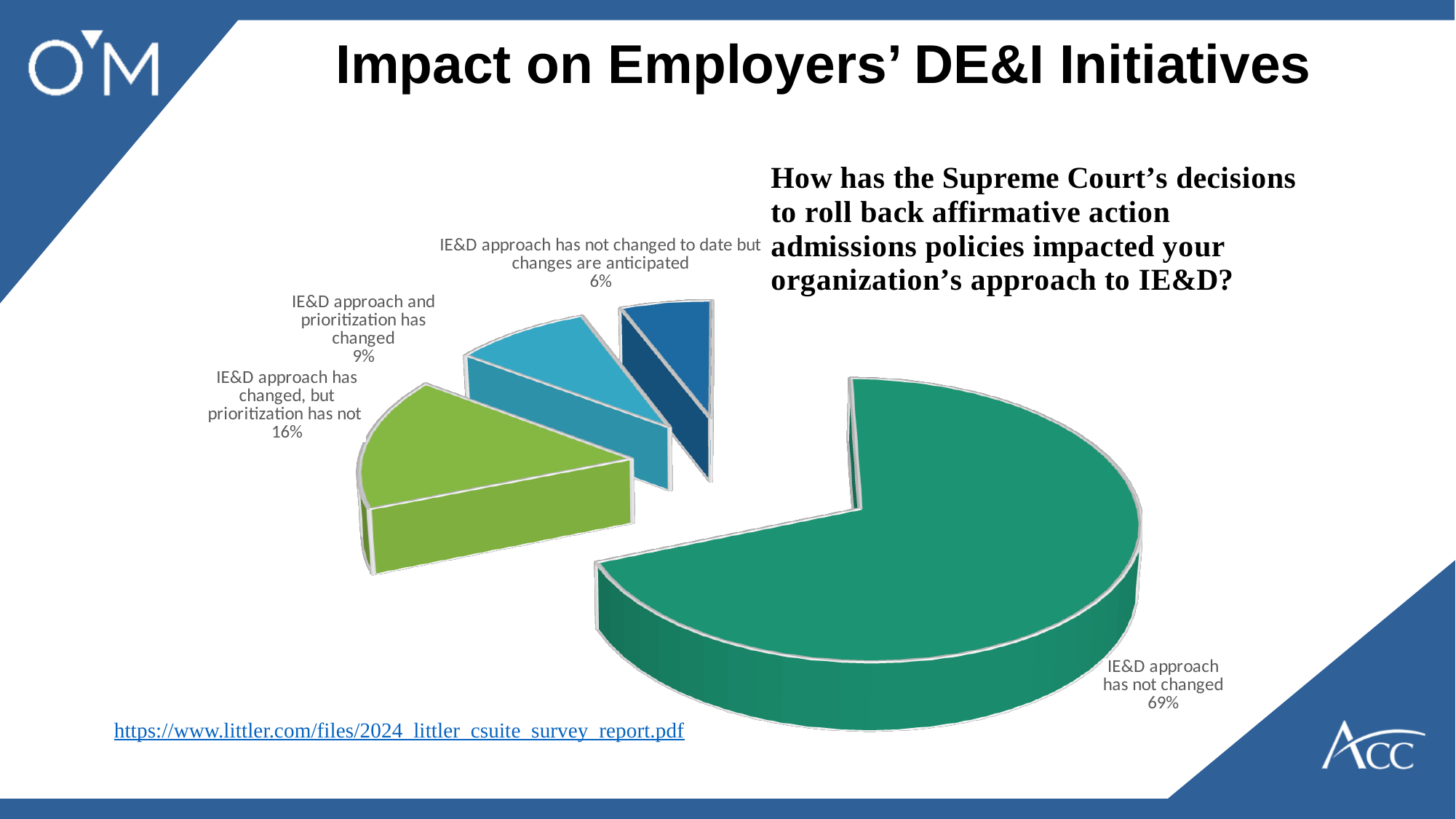
Which category has the smallest slice of the pie? IE&D approach has not changed to date but changes are anticipated What share of respondents said their IE&D approach has changed, but prioritization has not? 16% Which category has the largest slice of the pie? IE&D approach has not changed What kind of chart is shown on the slide? Pie chart What share of respondents said their IE&D approach has not changed to date but changes are anticipated? 6% What is the combined share of the three categories other than 'IE&D approach has not changed'? 31% What is the difference in percentage points between 'IE&D approach has not changed' and 'IE&D approach has changed, but prioritization has not'? 53 How many slices does the pie chart have? 4 What survey question does the pie chart answer, according to the text on the slide? How has the Supreme Court's decisions to roll back affirmative action admissions policies impacted your organization's approach to IE&D? What share of respondents said their IE&D approach and prioritization has changed? 9% Which is larger: the share for 'IE&D approach and prioritization has changed' or the share for 'IE&D approach has not changed to date but changes are anticipated'? IE&D approach and prioritization has changed What share of respondents said their IE&D approach has not changed? 69%